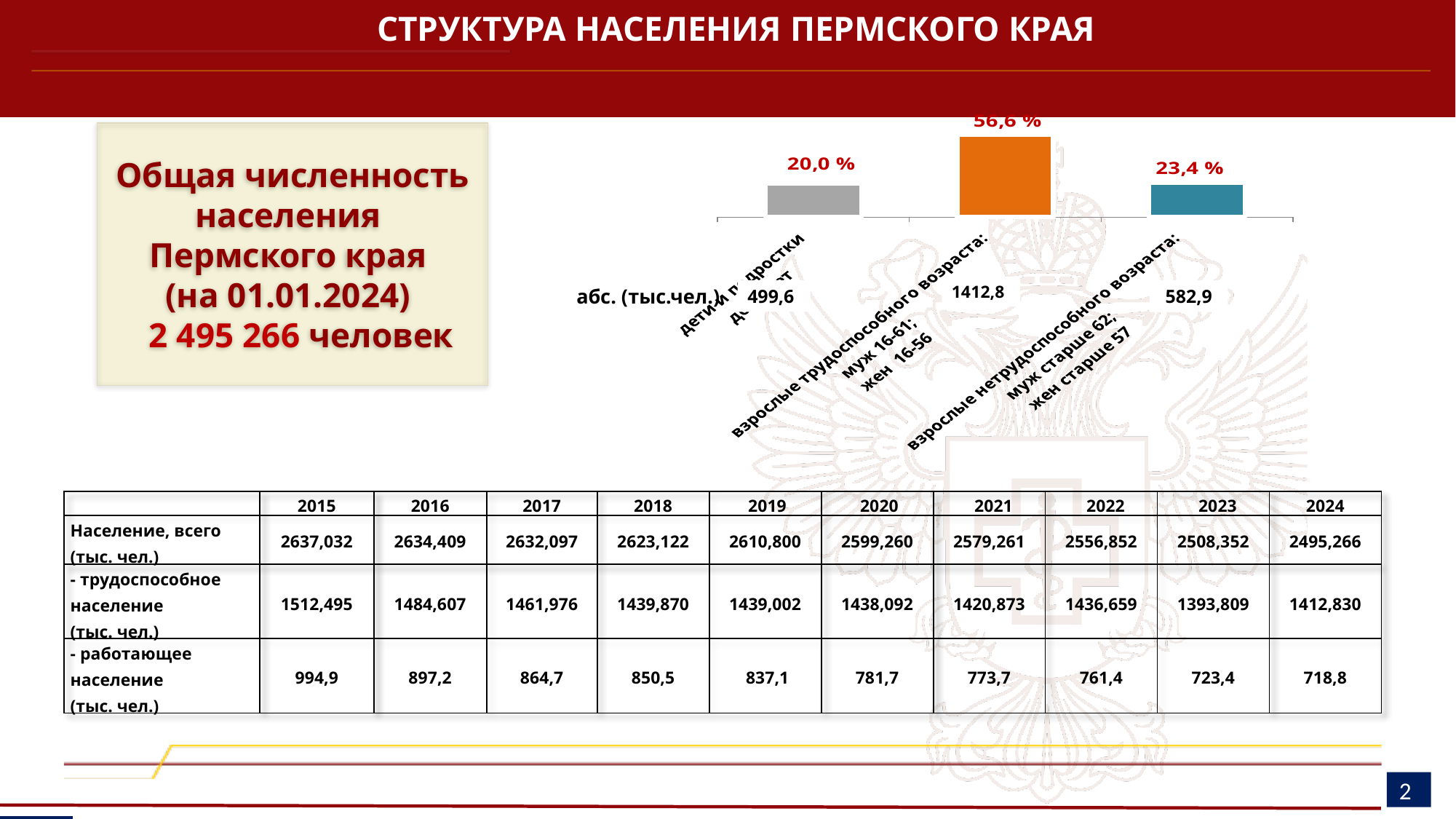
What percentage share does the chart show for взрослые нетрудоспособного возраста? 23,4 % What percentage share does the chart show for взрослые трудоспособного возраста? 56,6 % What colour is the bar for взрослые трудоспособного возраста? orange Which category has the lowest share in the bar chart? дети и подростки What is the absolute value (тыс.чел.) shown for взрослые трудоспособного возраста? 1412,8 Which category has the highest share in the bar chart? взрослые трудоспособного возраста What percentage share does the chart show for дети и подростки? 20,0 % What is the absolute value (тыс.чел.) shown for взрослые нетрудоспособного возраста? 582,9 Which is larger: the share for дети и подростки or the share for взрослые нетрудоспособного возраста? взрослые нетрудоспособного возраста What is the difference in percentage points between the share for взрослые трудоспособного возраста and the share for взрослые нетрудоспособного возраста? 33,2 What type of chart is shown on the slide? bar chart How many categories does the bar chart show? 3